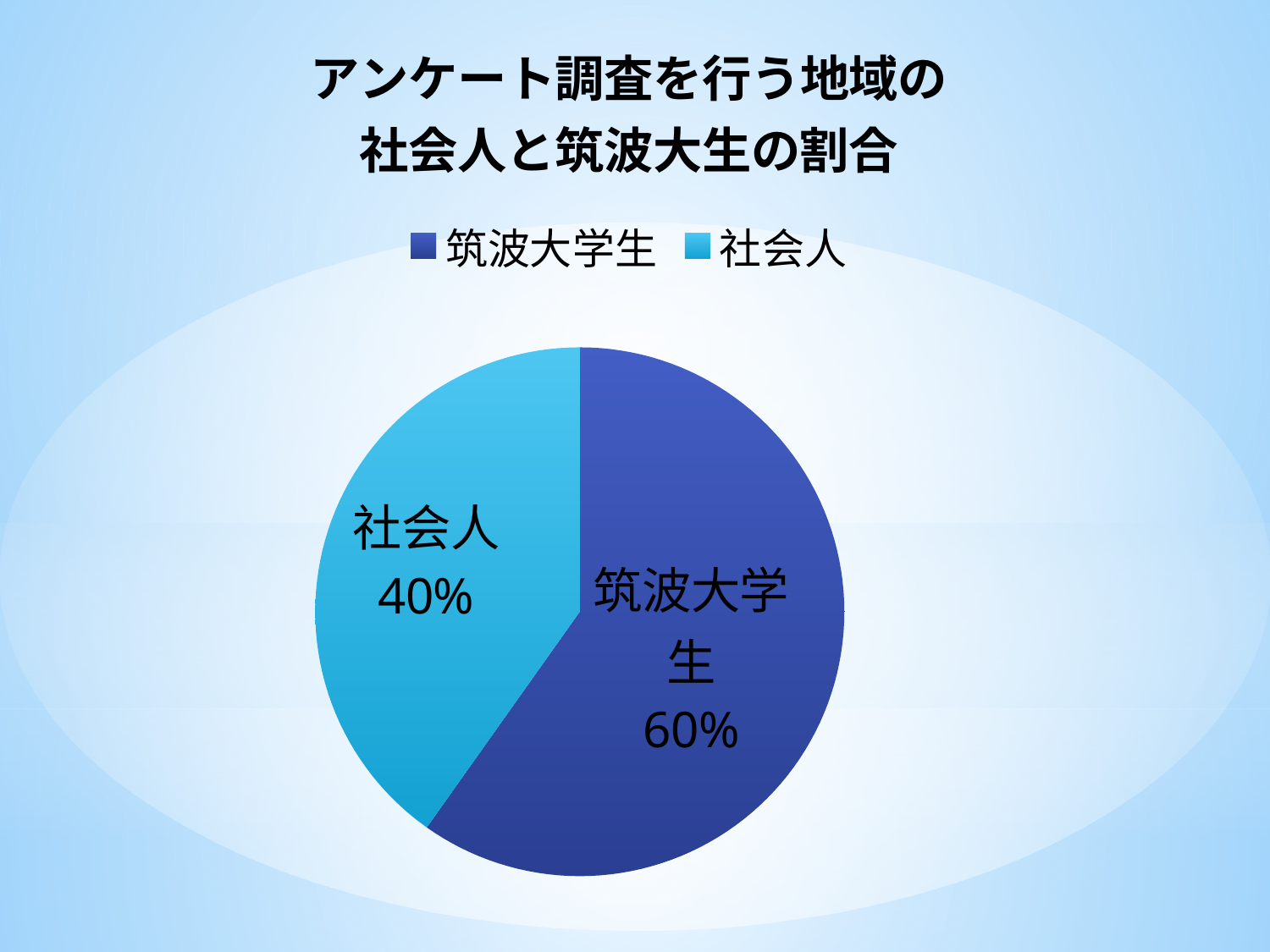
Which slice is the smallest? 社会人 What is the difference in percentage points between 筑波大学生 and 社会人? 20% What share of the pie does 社会人 have? 40% What share of the pie does 筑波大学生 have? 60% Which legend entry is shown in the lighter blue colour? 社会人 Which is larger, the share for 筑波大学生 or the share for 社会人? 筑波大学生 What is the title of the chart? アンケート調査を行う地域の社会人と筑波大生の割合 Which slice is the largest? 筑波大学生 How many slices does the pie chart have? 2 How many entries does the legend list? 2 What kind of chart is shown on the slide? pie chart